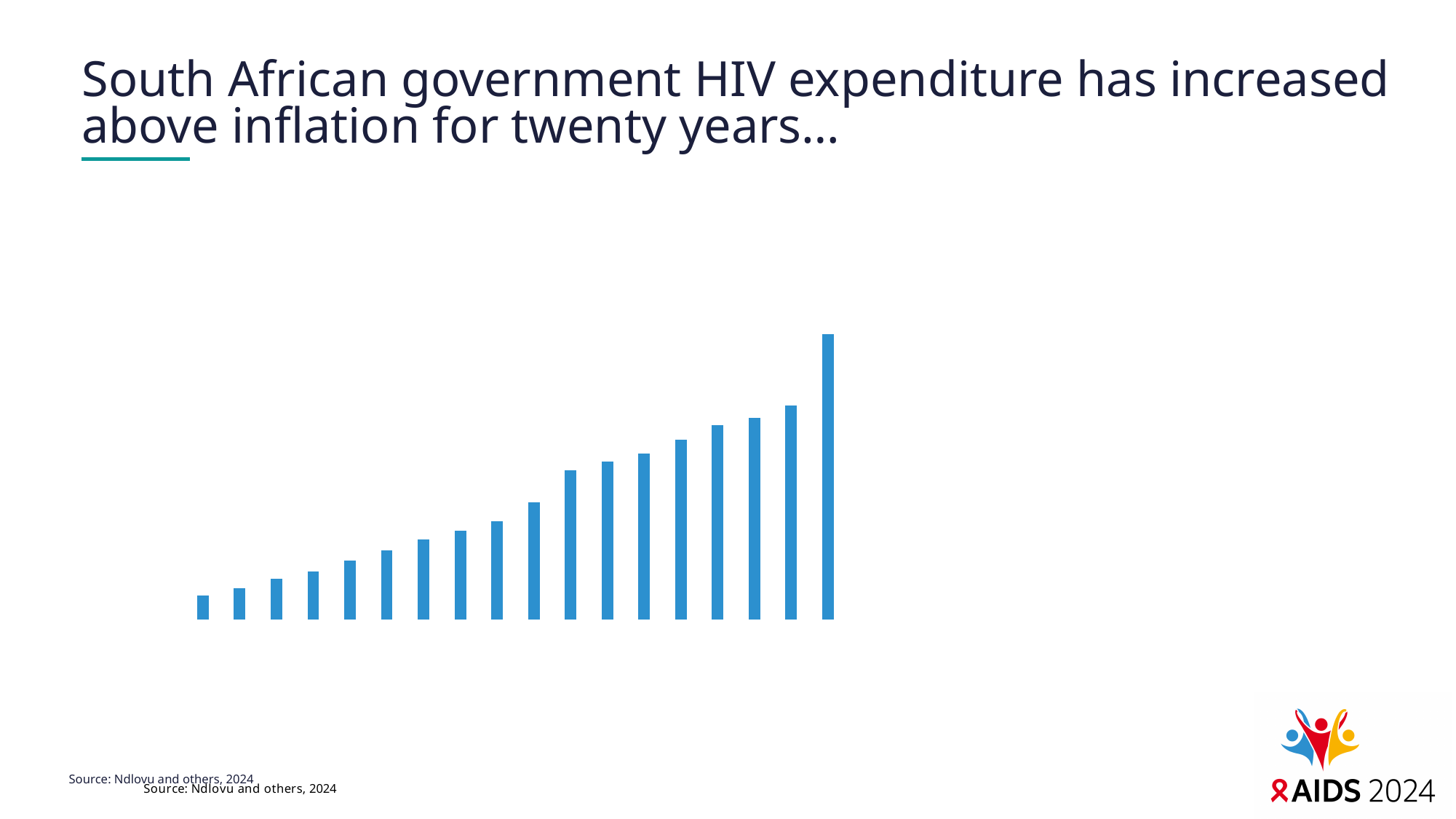
How many bars does the chart contain? 18 Do the bar values generally rise or fall from left to right across the chart? rise What kind of chart is shown on the slide? bar chart What colour are the bars in the chart? blue Does the chart display any data labels on the bars? No Which bar is the shortest in the chart? the leftmost bar Which is taller, the leftmost bar or the rightmost bar? the rightmost bar Which bar is the tallest in the chart? the rightmost bar Which is taller, the second bar from the right or the third bar from the right? the second bar from the right